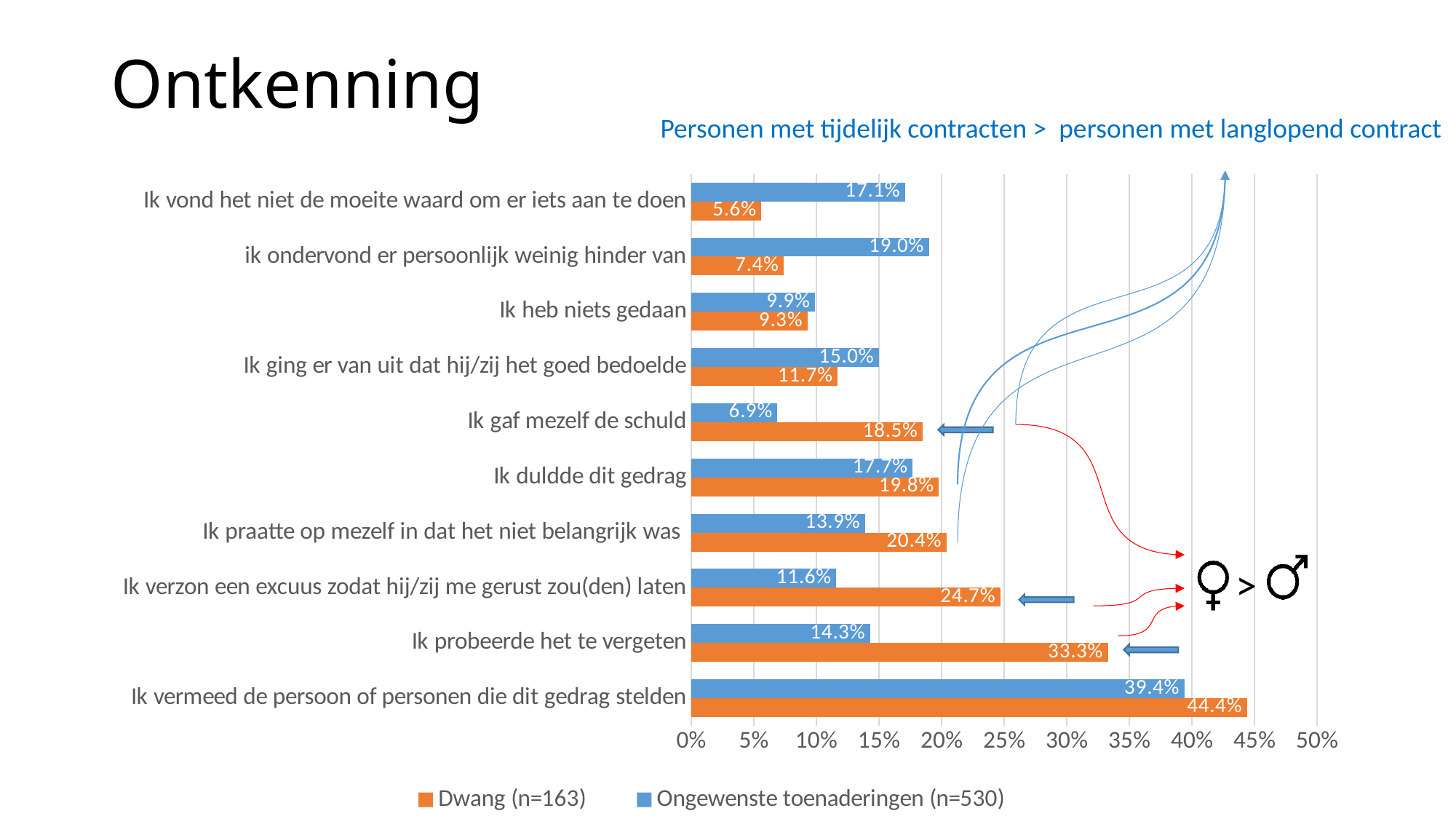
What kind of chart is shown on the slide? bar chart What is the difference between the Dwang (n=163) and Ongewenste toenaderingen (n=530) values for "Ik verzon een excuus zodat hij/zij me gerust zou(den) laten"? 13.1% Which category has the lowest value for Ongewenste toenaderingen (n=530)? Ik gaf mezelf de schuld Which colour represents the Dwang (n=163) series? orange Is the value for Dwang (n=163) for "Ik vermeed de persoon of personen die dit gedrag stelden" greater or less than 40%? greater What is the value for Ongewenste toenaderingen (n=530) for "Ik gaf mezelf de schuld"? 6.9% What is the value for Dwang (n=163) for "Ik probeerde het te vergeten"? 33.3% What is the value for Dwang (n=163) for "Ik vond het niet de moeite waard om er iets aan te doen"? 5.6% How many categories are shown on the chart? 10 For "ik ondervond er persoonlijk weinig hinder van", which series has the larger value: Dwang (n=163) or Ongewenste toenaderingen (n=530)? Ongewenste toenaderingen (n=530) Which category has the highest value for Dwang (n=163)? Ik vermeed de persoon of personen die dit gedrag stelden How many series does the legend list? 2